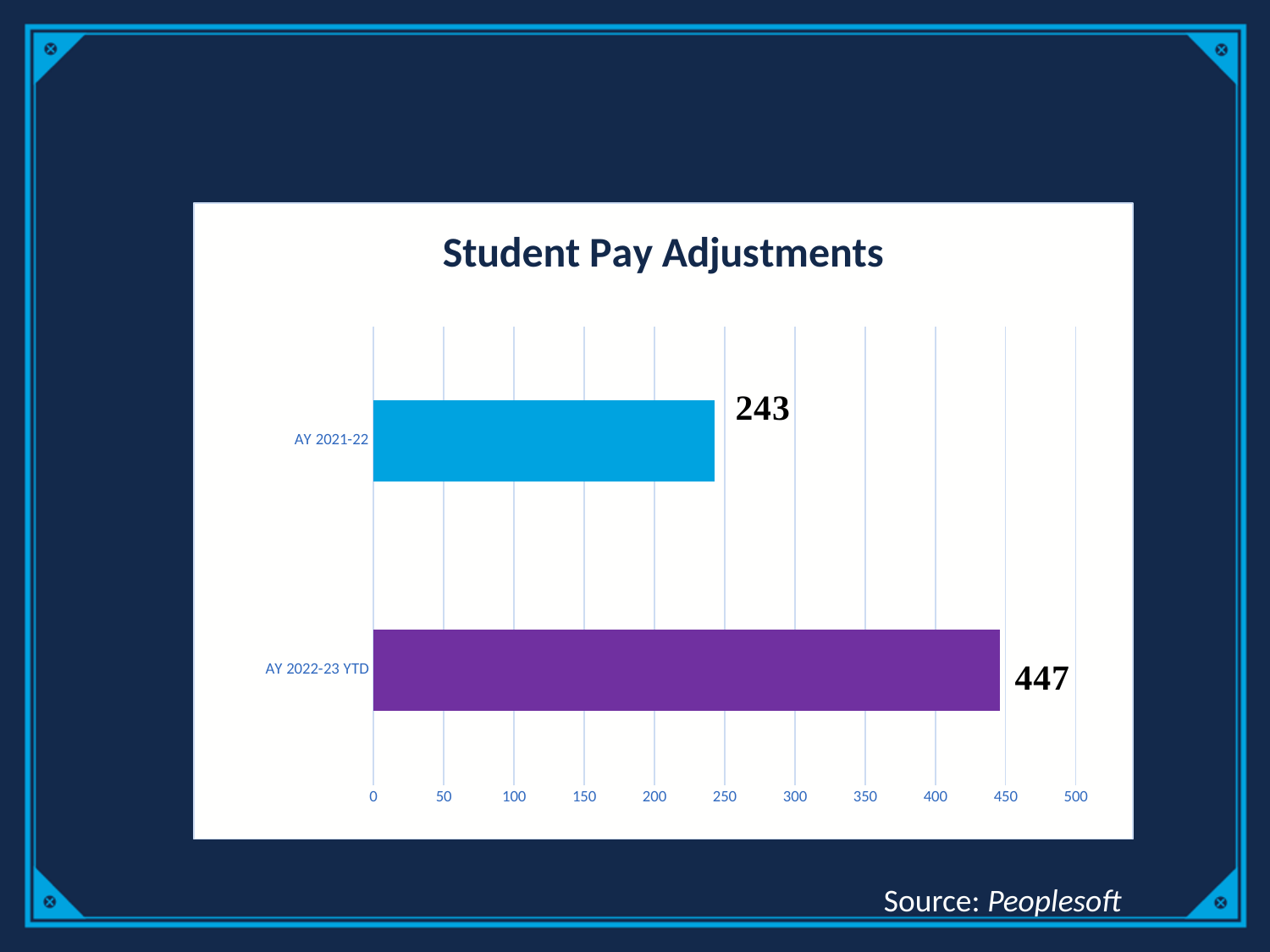
What kind of chart is shown on the slide? bar chart Which category has the lowest value? AY 2021-22 Is the value for AY 2022-23 YTD greater or less than 400? greater What is the difference between the values for AY 2022-23 YTD and AY 2021-22? 204 Which is larger, the value for AY 2021-22 or the value for AY 2022-23 YTD? AY 2022-23 YTD How many categories are shown in the chart? 2 What is the value for AY 2021-22? 243 Which category has the highest value? AY 2022-23 YTD Is the value for AY 2021-22 greater or less than 300? less What colour is the bar for AY 2022-23 YTD? purple What is the value for AY 2022-23 YTD? 447 What is the title of the chart? Student Pay Adjustments